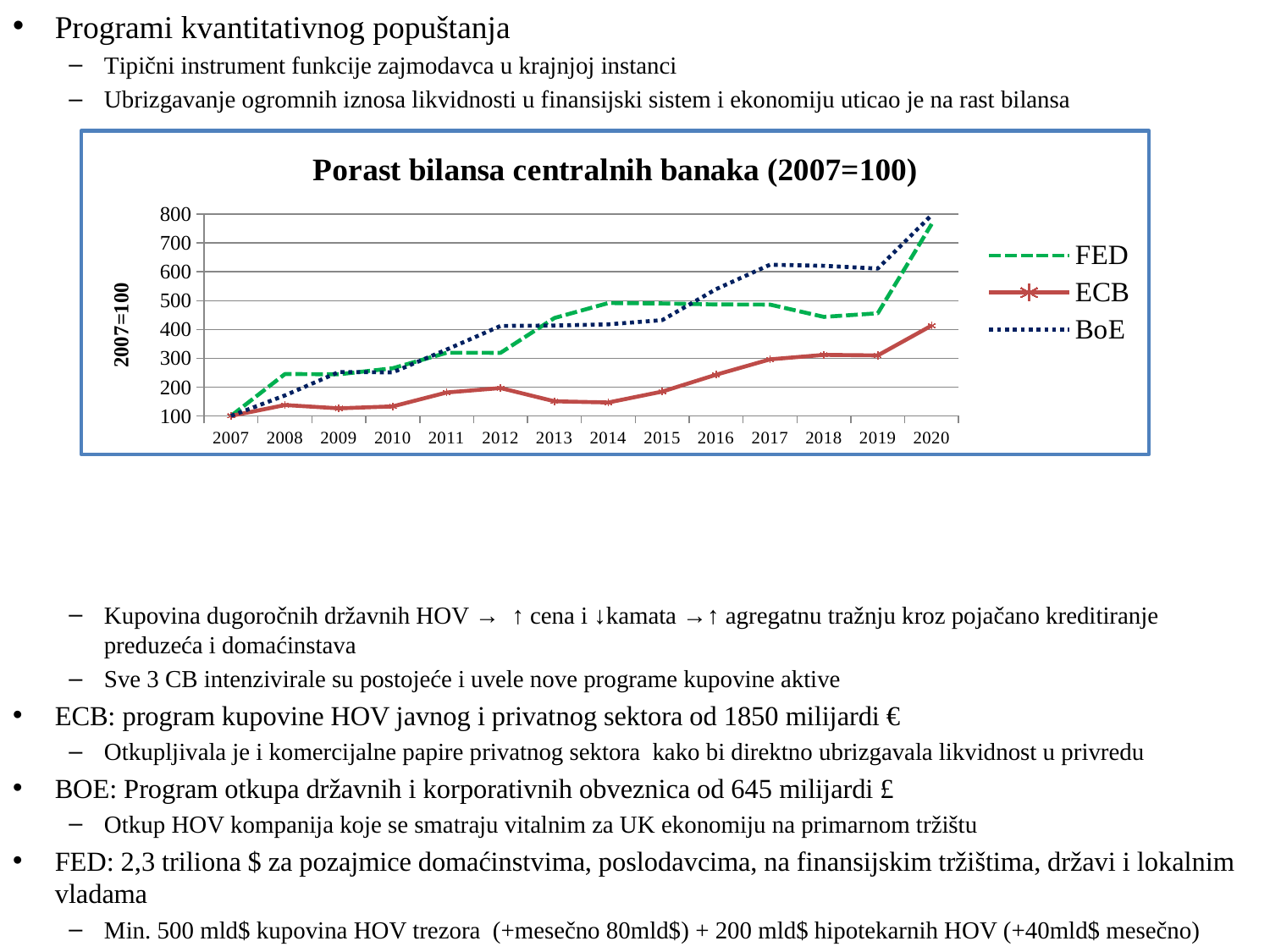
Is the value for ECB in 2020 greater or less than 500? less Which series has the lowest value in 2020? ECB In 2014, which is larger, the value for FED or the value for ECB? FED In 2017, which is larger, the value for BoE or the value for FED? BoE What is the value for ECB in 2007? 100 Which series has the highest value in 2017? BoE How many series does the legend of the chart list? 3 Is the value for FED in 2014 greater or less than 400? greater What is the title of the chart? Porast bilansa centralnih banaka (2007=100) Is the value for BoE in 2017 greater or less than 500? greater What kind of chart is shown on the slide? line chart How many years are shown on the x axis of the chart? 14